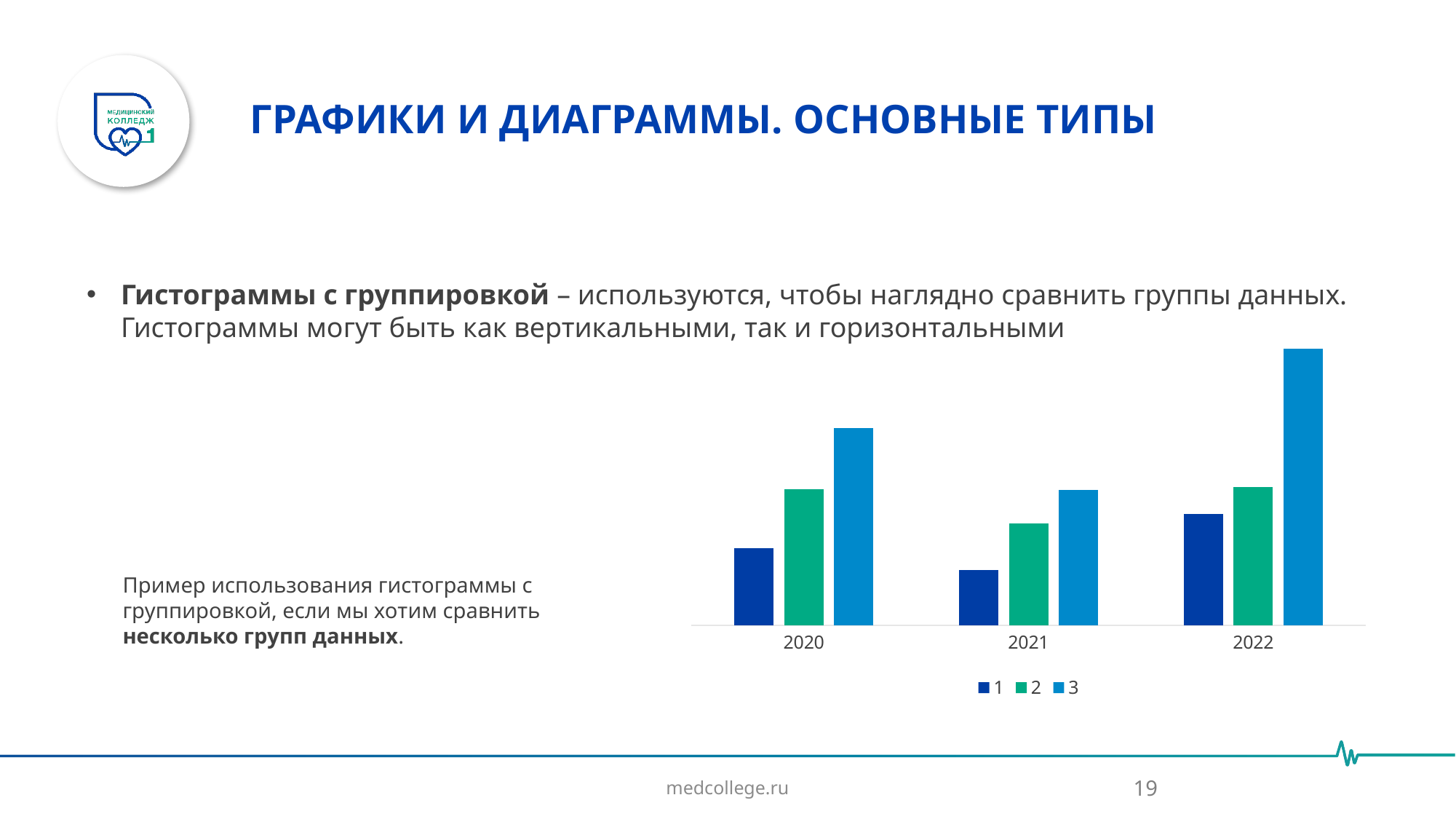
What are the entries listed in the chart's legend? 1, 2, 3 For series 2, which is larger: the value for 2020 or the value for 2021? 2020 What are the category labels on the x axis of the chart? 2020, 2021, 2022 Which series has the lowest value in 2021? 1 Which year has the lowest value for series 1? 2021 Which year has the lowest value for series 3? 2021 In 2020, which is larger: the value for series 1 or the value for series 3? series 3 What kind of chart is shown on the slide? bar chart Which year has the highest value for series 3? 2022 How many series does the chart's legend list? 3 Which series has the highest value in 2022? 3 How many categories are shown on the x axis of the chart? 3